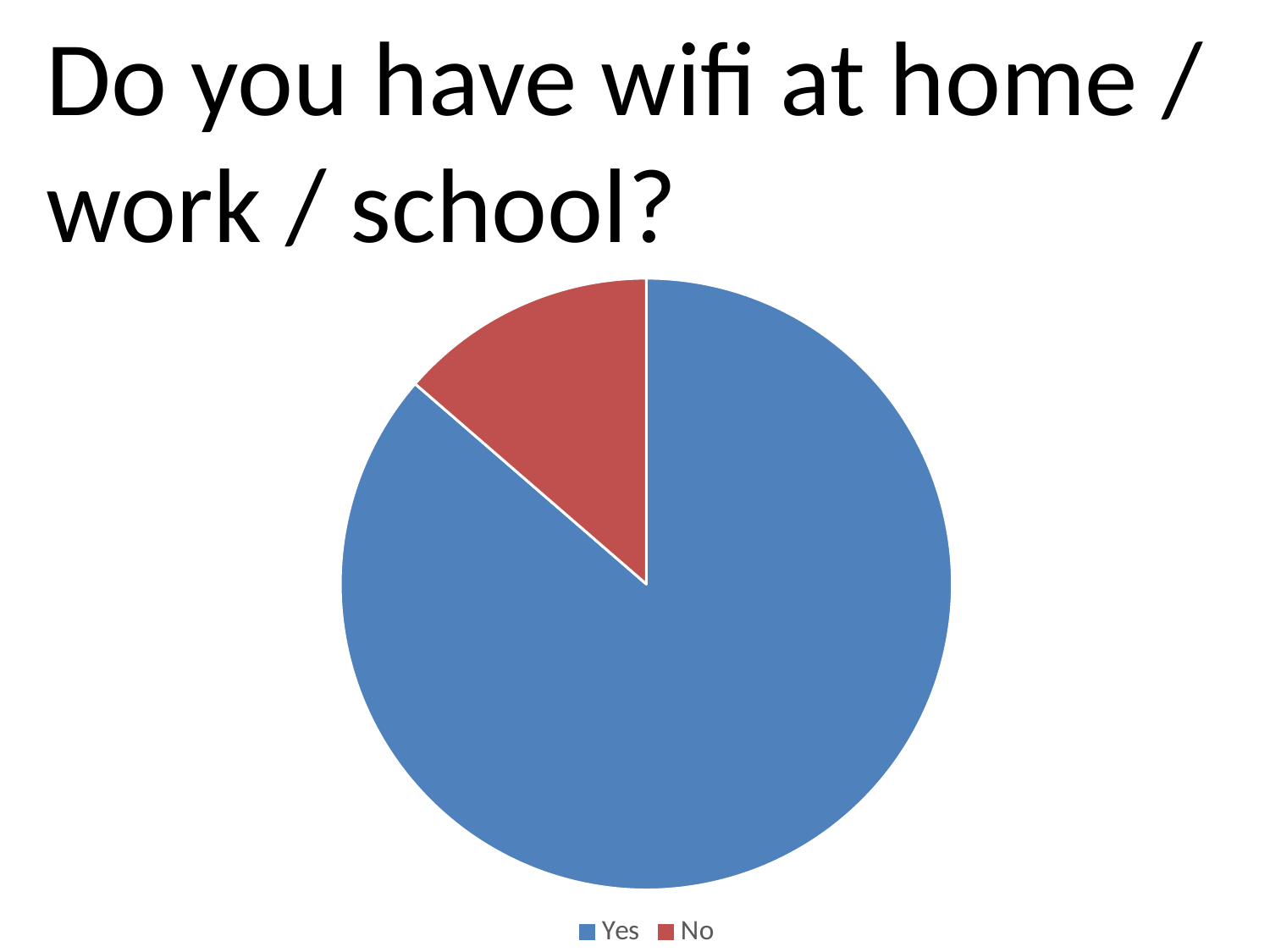
How many slices does the pie chart have? 2 What kind of chart is shown on the slide? pie chart What is the title of the slide above the chart? Do you have wifi at home / work / school? Which category has the smallest slice of the pie? No Which slice is larger, Yes or No? Yes How many entries does the legend list? 2 Which category has the largest slice of the pie? Yes What colour is the Yes slice? blue